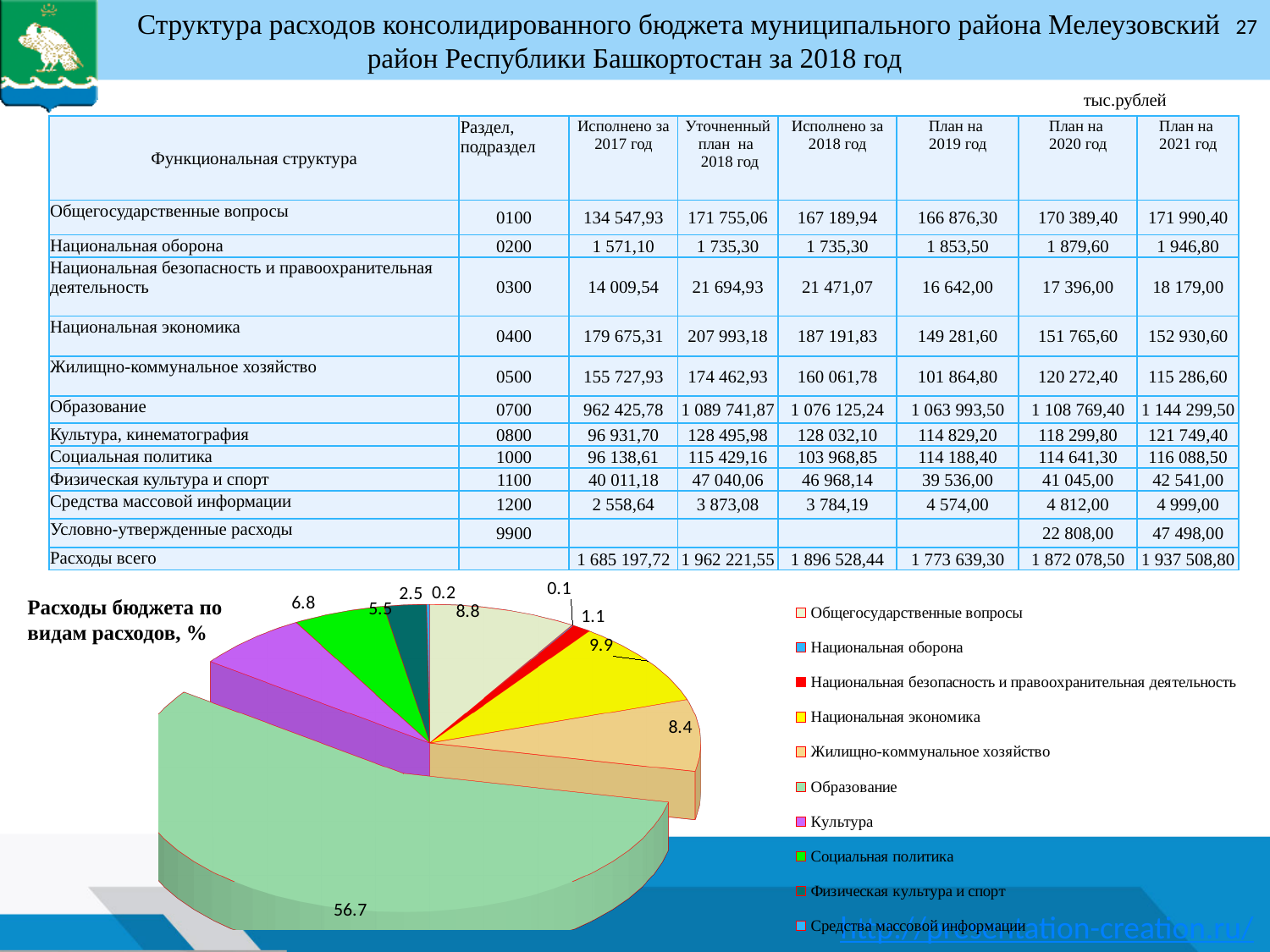
Which category has the largest slice in the pie chart? Образование In the pie chart, what share is shown for Образование? 56.7 In the pie chart, what share is shown for Национальная экономика? 9.9 How many categories does the legend of the pie chart list? 10 What kind of chart is shown at the bottom of the slide? pie chart In the pie chart, what share is shown for Жилищно-коммунальное хозяйство? 8.4 In the pie chart, how much larger is the share for Национальная экономика than for Общегосударственные вопросы? 1.1 In the pie chart, which is larger: the share for Культура or for Социальная политика? Культура Which category has the smallest slice in the pie chart? Национальная оборона In the pie chart, what share is shown for Культура? 6.8 In the pie chart, what share is shown for Физическая культура и спорт? 2.5 What is the title of the pie chart? Расходы бюджета по видам расходов, %